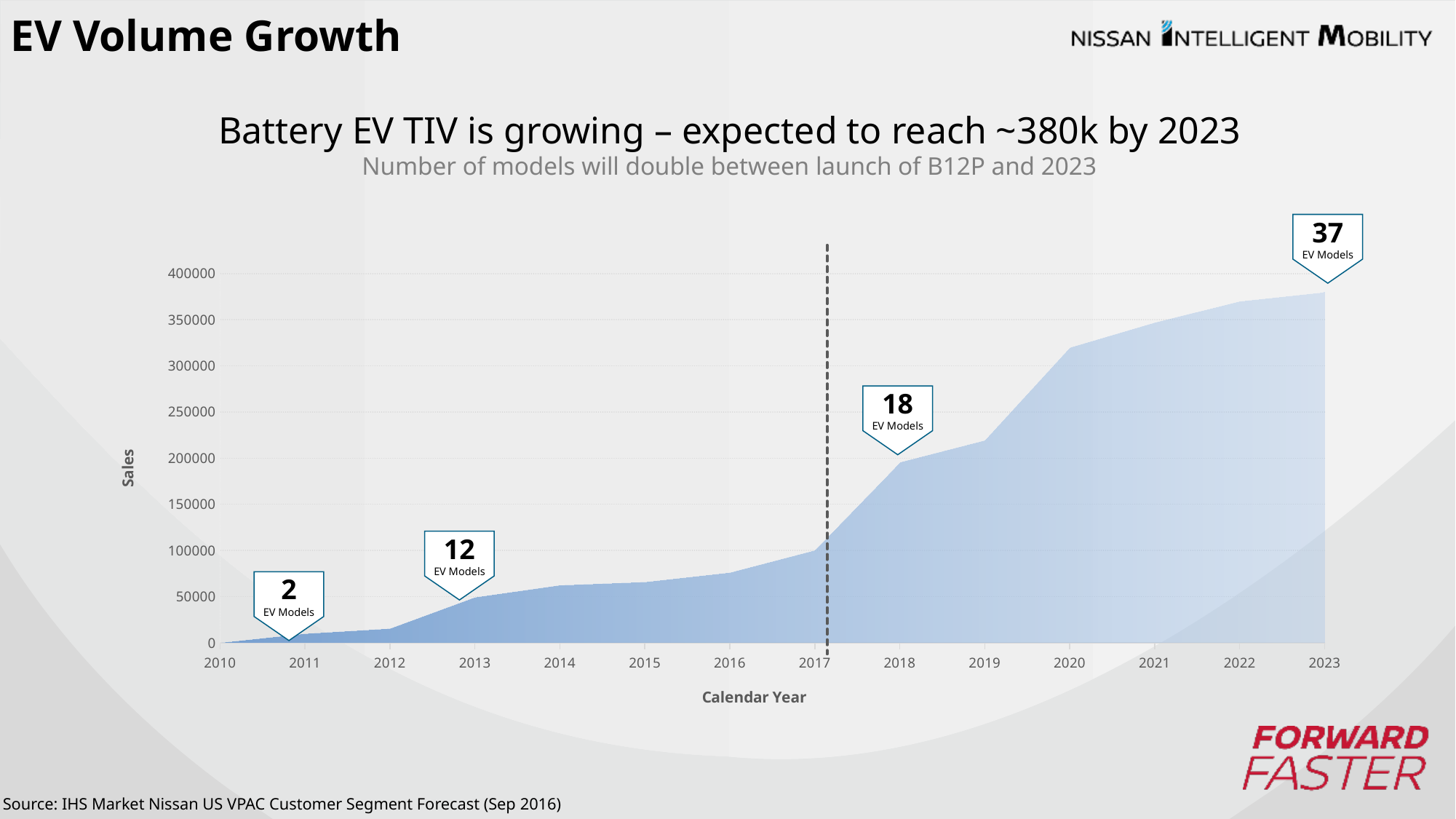
Which calendar year has the lowest sales? 2010 What kind of chart is shown on the slide? area chart Do sales rise or fall from 2010 to 2023? rise How many EV models does the callout show for 2023? 37 Are sales in 2020 higher or lower than in 2019? higher Is the sales value for 2023 greater or less than 350000? greater Which calendar year has the highest sales? 2023 Is the sales value for 2016 greater or less than 100000? less Is the sales value for 2012 greater or less than 50000? less What is the label of the y axis? Sales How many calendar years are plotted along the x axis? 14